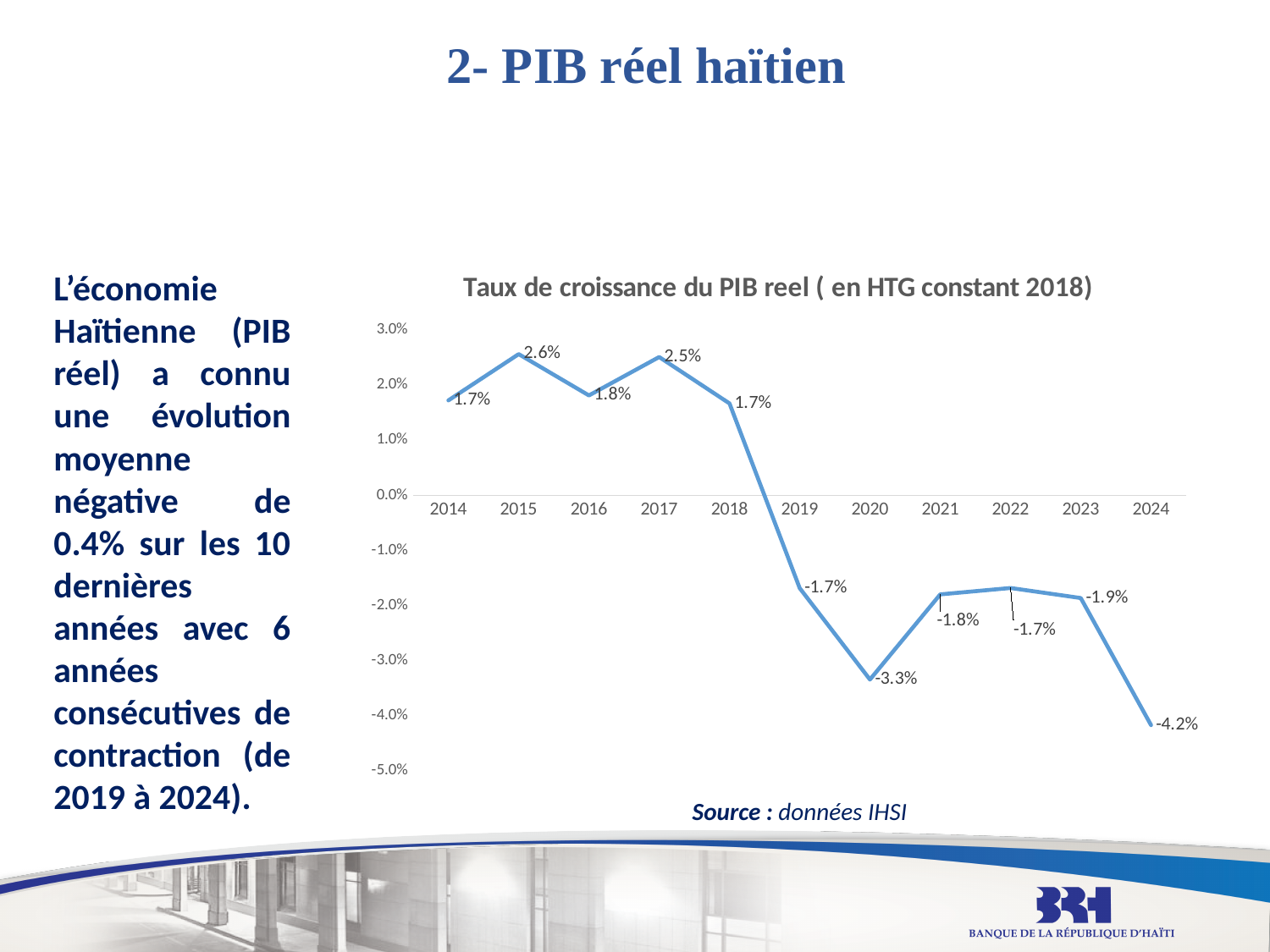
What is the real GDP growth rate for 2024? -4.2% What type of chart is shown on the slide? Line chart Which year has the lowest real GDP growth rate? 2024 What is the title of the chart? Taux de croissance du PIB reel ( en HTG constant 2018) Which year has the highest real GDP growth rate? 2015 What is the real GDP growth rate for 2020? -3.3% Which year has a higher growth rate, 2016 or 2017? 2017 How many years are plotted on the chart? 11 What is the difference between the growth rate in 2017 and the growth rate in 2018? 0.8% Does the growth rate rise or fall from 2018 to 2020? Fall Is the value for 2020 greater or less than -3.0%? less What is the real GDP growth rate for 2015? 2.6%